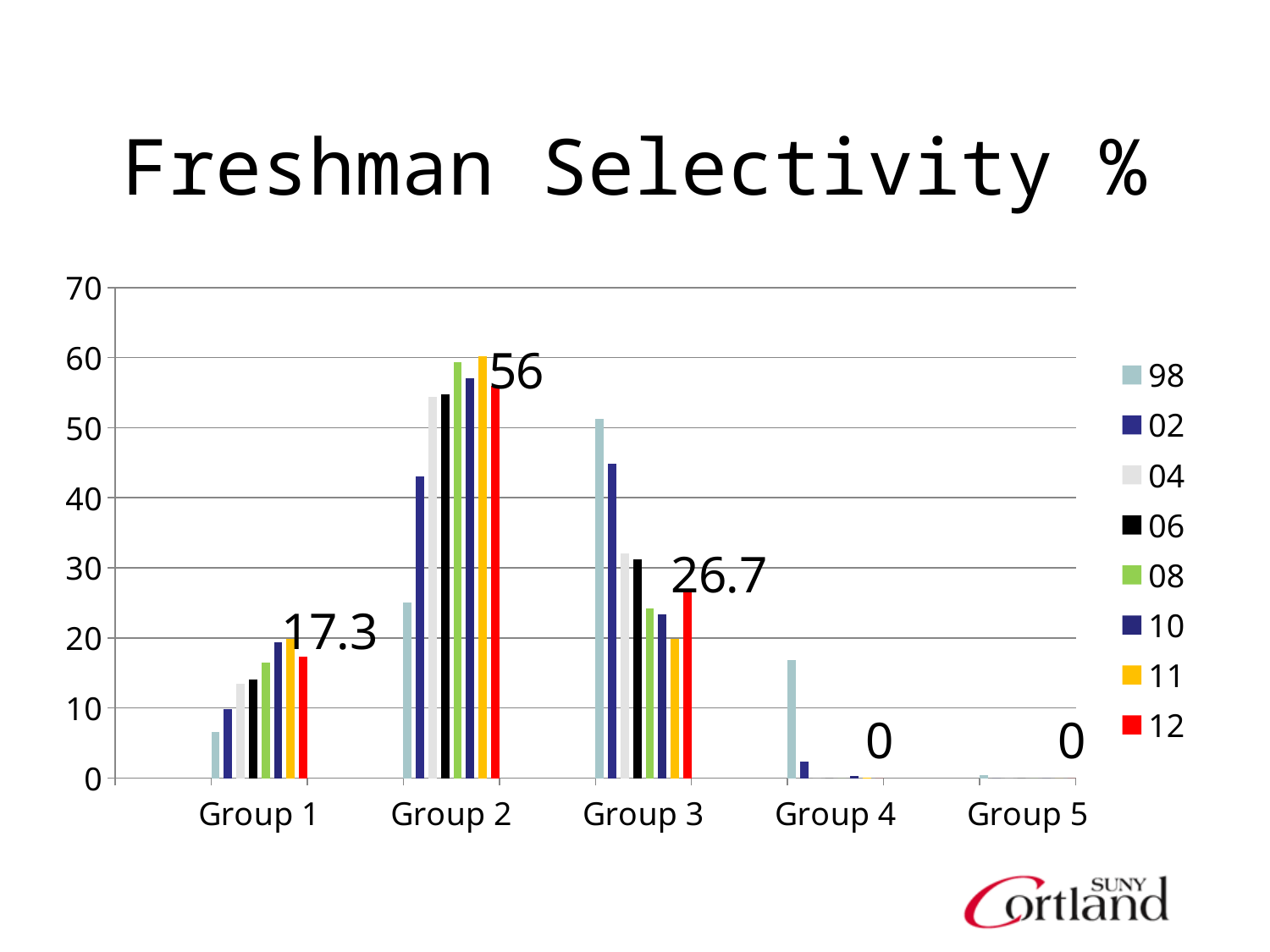
What is the value for series 12 in Group 3? 26.7 How many series does the legend list? 8 What kind of chart is shown on the slide? Bar chart For series 12, which is larger: Group 2 or Group 3? Group 2 What is the value for series 12 in Group 1? 17.3 Is the value for series 98 in Group 2 greater or less than 30? less Is the value for series 02 in Group 3 greater or less than 40? greater What is the difference between the series 12 values for Group 2 and Group 1? 38.7 What is the value for series 12 in Group 4? 0 What is the value for series 12 in Group 2? 56 Among the labelled values for series 12, which group has the highest value? Group 2 How many groups are shown on the x axis? 5